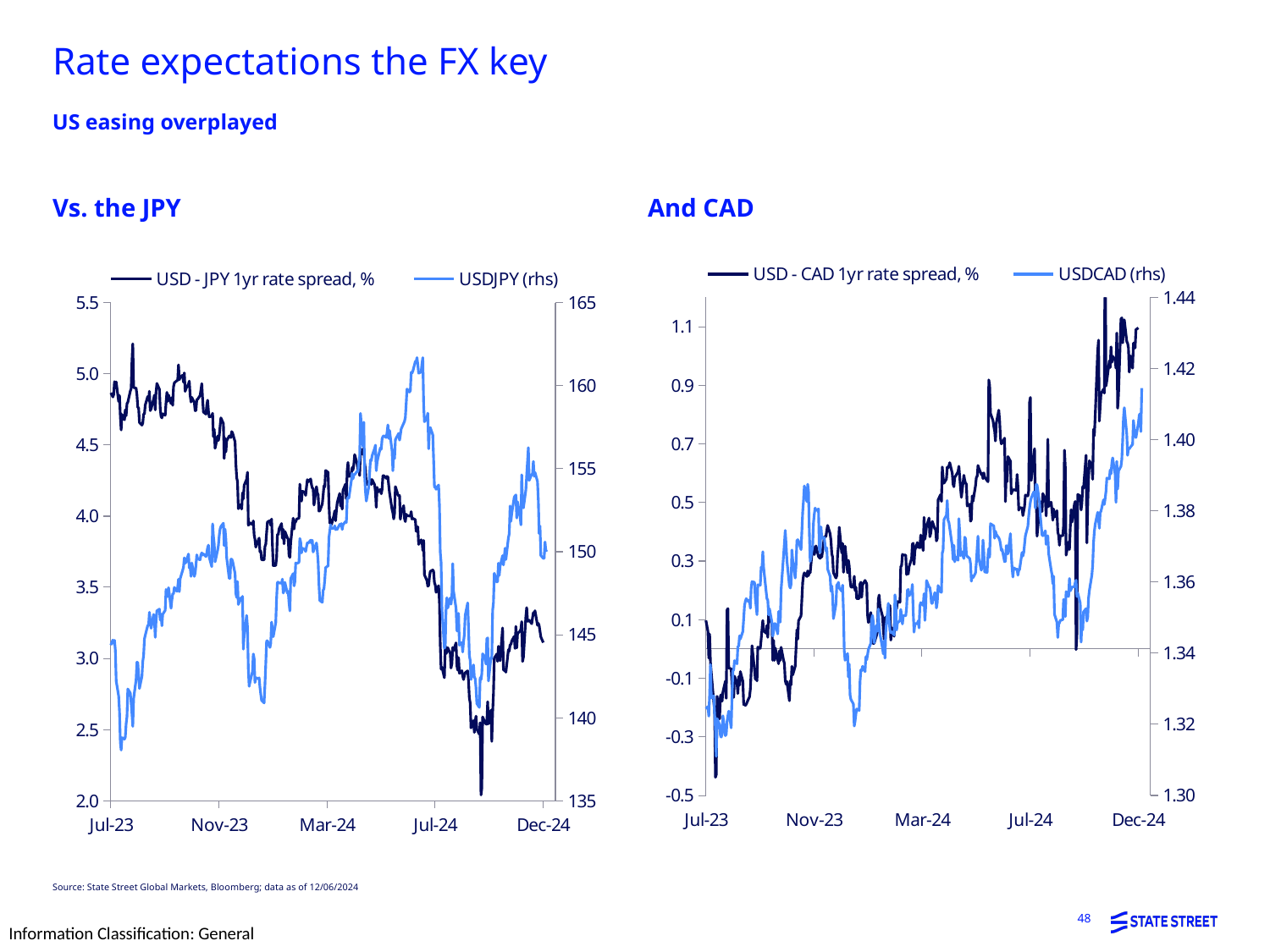
In the 'And CAD' chart, is the USDCAD value at Dec-24 greater or less than 1.38? greater In the 'Vs. the JPY' chart, is the USDJPY value at its peak around Jul-24 greater or less than 155? greater In the 'Vs. the JPY' chart, is the USD - JPY 1yr rate spread at Jul-23 greater or less than 4.5? greater In the 'And CAD' chart, what is the name of the dark blue series? USD - CAD 1yr rate spread, % What kind of chart is the 'Vs. the JPY' chart? line chart In the 'Vs. the JPY' chart, which series is plotted on the right-hand axis? USDJPY (rhs) In the 'And CAD' chart, does the USD - CAD 1yr rate spread overall rise or fall from Jul-23 to Dec-24? rise In the 'Vs. the JPY' chart, does the USD - JPY 1yr rate spread overall rise or fall from Jul-23 to Dec-24? fall How many series does the legend of the 'And CAD' chart list? 2